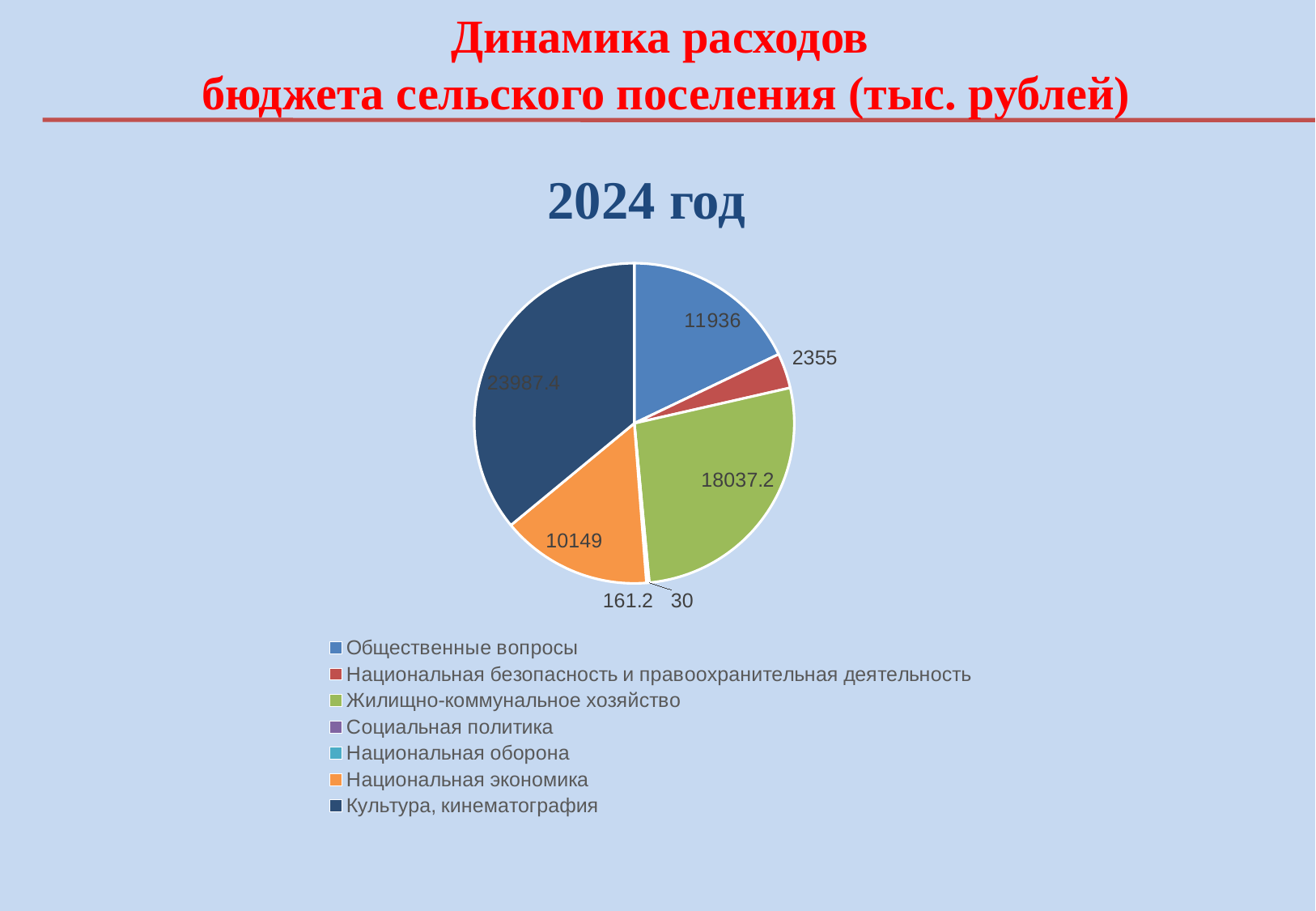
What is the value for Национальная безопасность и правоохранительная деятельность? 2355 Which category has the smallest slice of the pie? Социальная политика What is the title shown above the pie chart? 2024 год What is the value for Жилищно-коммунальное хозяйство? 18037.2 How many categories does the legend list? 7 Which is larger, Общественные вопросы or Национальная экономика? Общественные вопросы What is the value for Общественные вопросы in the 2024 год pie chart? 11936 What type of chart is shown on the slide? pie chart Which category has the largest slice of the pie? Культура, кинематография What is the value for Культура, кинематография? 23987.4 What is the value for Национальная экономика? 10149 What is the difference between Культура, кинематография and Жилищно-коммунальное хозяйство? 5950.2